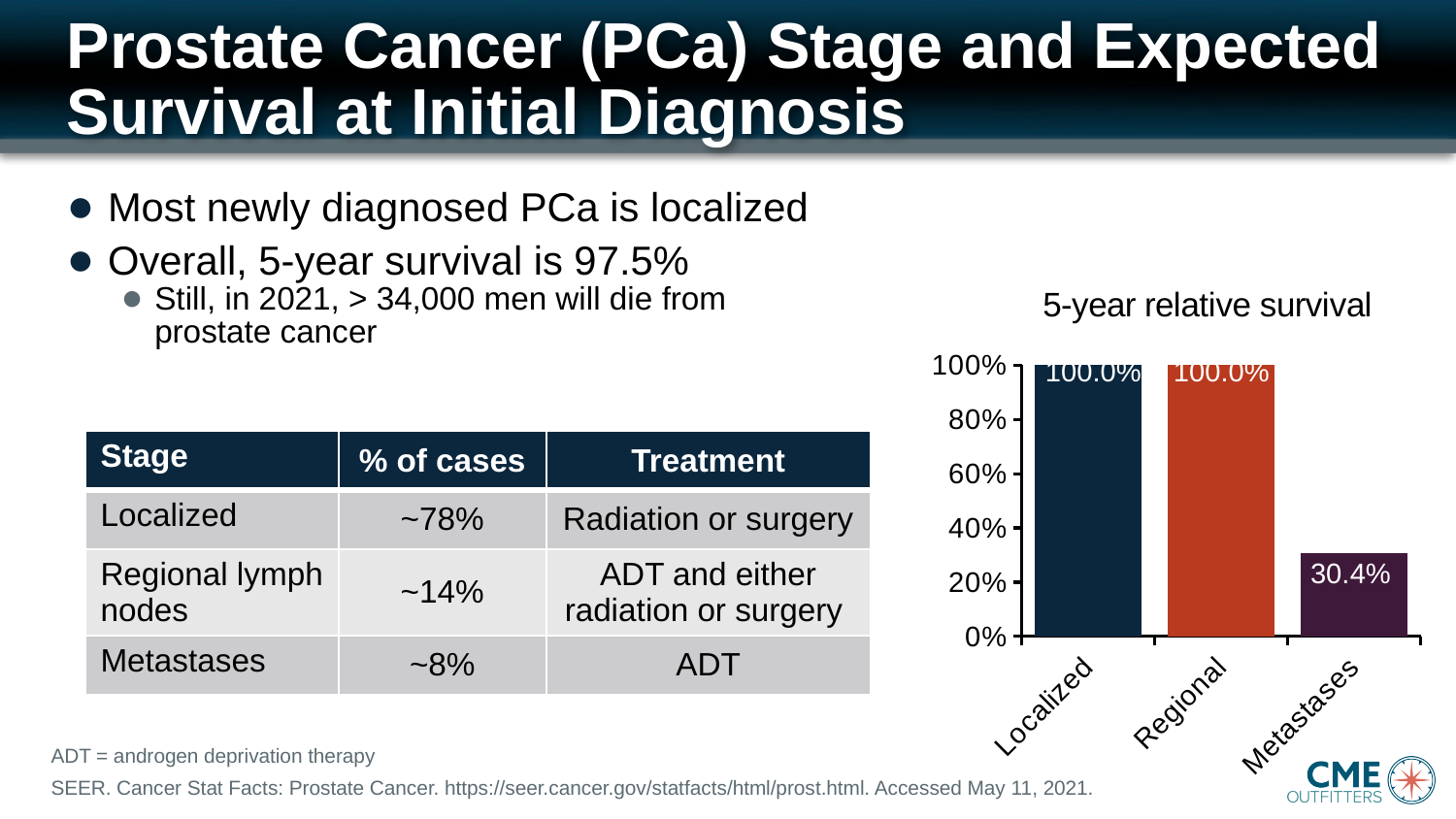
What is the highest value shown on the y axis of the chart? 100% What is the 5-year relative survival value for Metastases in the chart? 30.4% Which category has the lowest 5-year relative survival in the chart? Metastases Which is larger, the 5-year relative survival for Regional or for Metastases? Regional How many categories are shown on the x axis of the chart? 3 What is the difference between the 5-year relative survival for Localized and Metastases? 69.6% Do the values in the chart rise or fall from Localized to Metastases along the x axis? fall Is the value for Metastases greater or less than 40%? less What is the title of the chart? 5-year relative survival What is the 5-year relative survival value for Regional in the chart? 100.0% What kind of chart is shown on the slide? bar chart What is the 5-year relative survival value for Localized in the chart? 100.0%